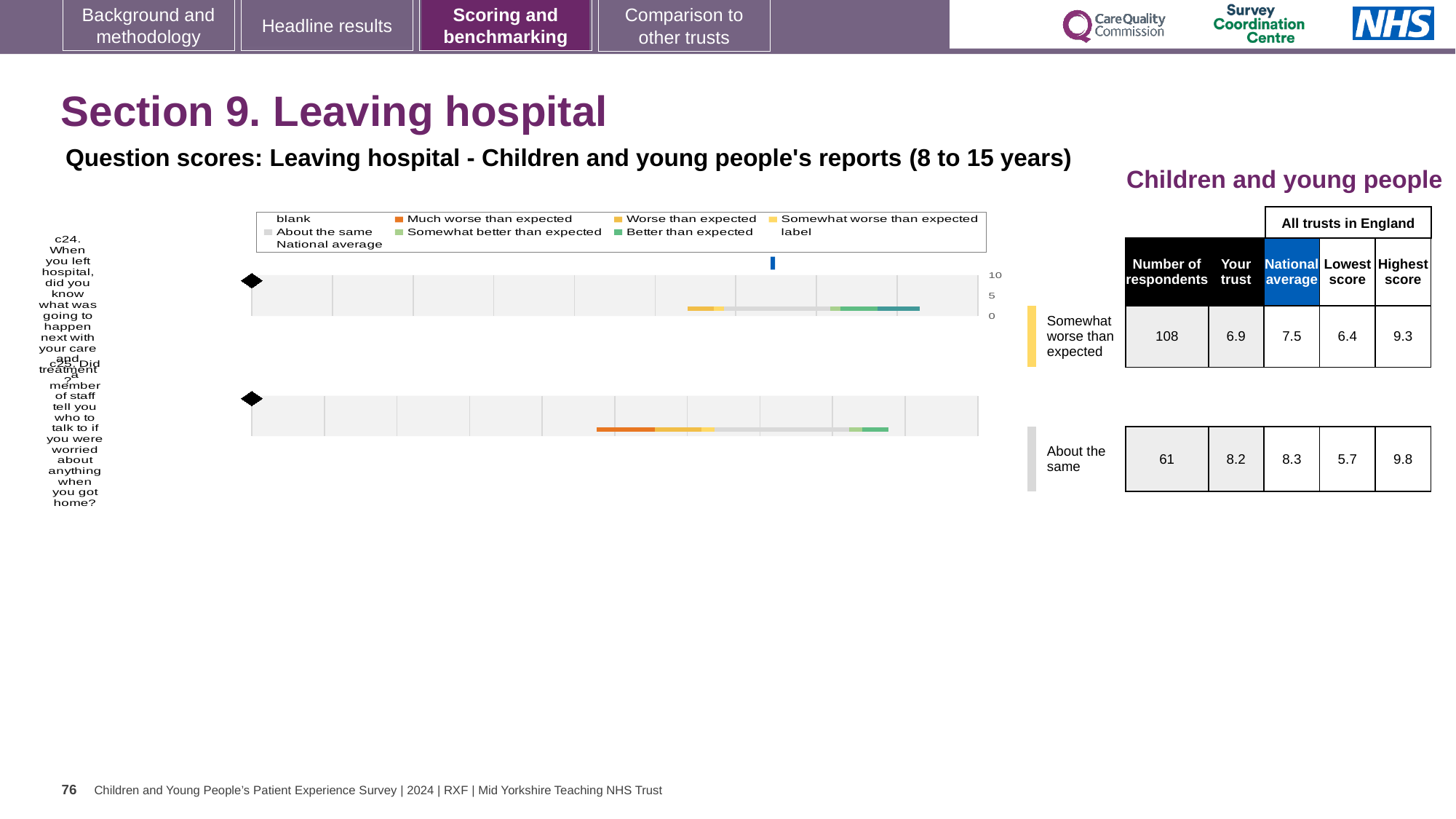
What benchmark category is question c25 placed in? About the same Is the trust's score for question c25 greater or less than 5? greater What benchmark category is question c24 placed in? Somewhat worse than expected What is the highest score across all trusts in England for question c25? 9.8 How many questions (bars) are plotted in the chart? 2 What kind of chart is used to show the question scores on this slide? bar chart How many respondents answered question c24? 108 What is the lowest score across all trusts in England for question c24? 6.4 What is the difference between the national average and the trust's score for question c24? 0.6 Which question has the higher 'Your trust' score, c24 or c25? c25 What is the national average score for question c25 (Did a member of staff tell you who to talk to if you were worried about anything when you got home?)? 8.3 What is the 'Your trust' score for question c24 (When you left hospital, did you know what was going to happen next with your care and treatment?)? 6.9